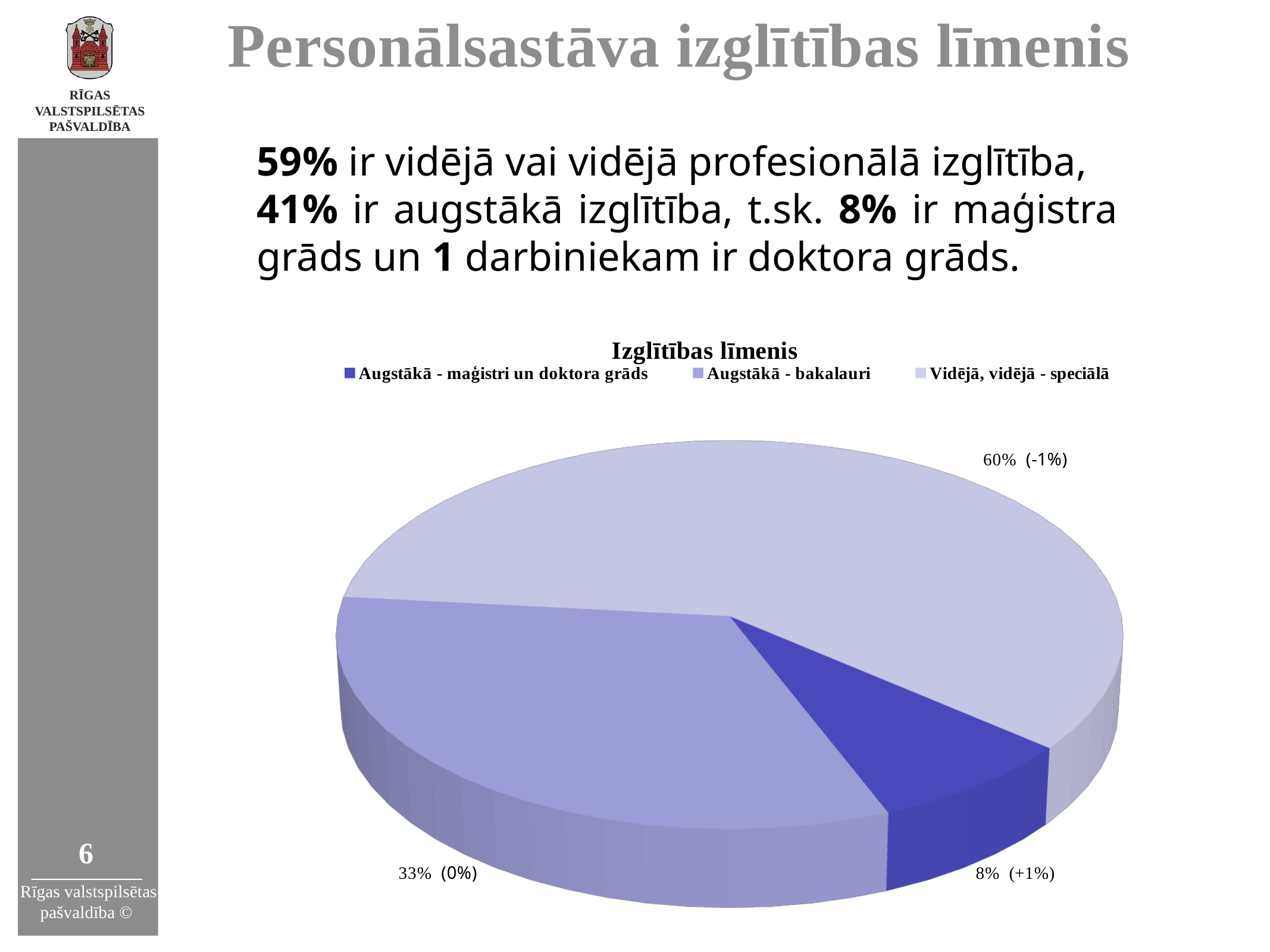
How many entries does the chart legend list? 3 What change is shown in parentheses next to the 8% label? +1% What share of the pie is "Augstākā - maģistri un doktora grāds"? 8% Which is larger: the "Augstākā - bakalauri" slice or the "Augstākā - maģistri un doktora grāds" slice? Augstākā - bakalauri Which category has the largest slice of the pie? Vidējā, vidējā - speciālā What is the difference in percentage points between the "Vidējā, vidējā - speciālā" slice and the "Augstākā - bakalauri" slice? 27 What is the title of the chart? Izglītības līmenis What share of the pie is "Vidējā, vidējā - speciālā"? 60% What kind of chart is shown on the slide? pie chart How many slices does the pie chart have? 3 What share of the pie is "Augstākā - bakalauri"? 33% Which category has the smallest slice of the pie? Augstākā - maģistri un doktora grāds